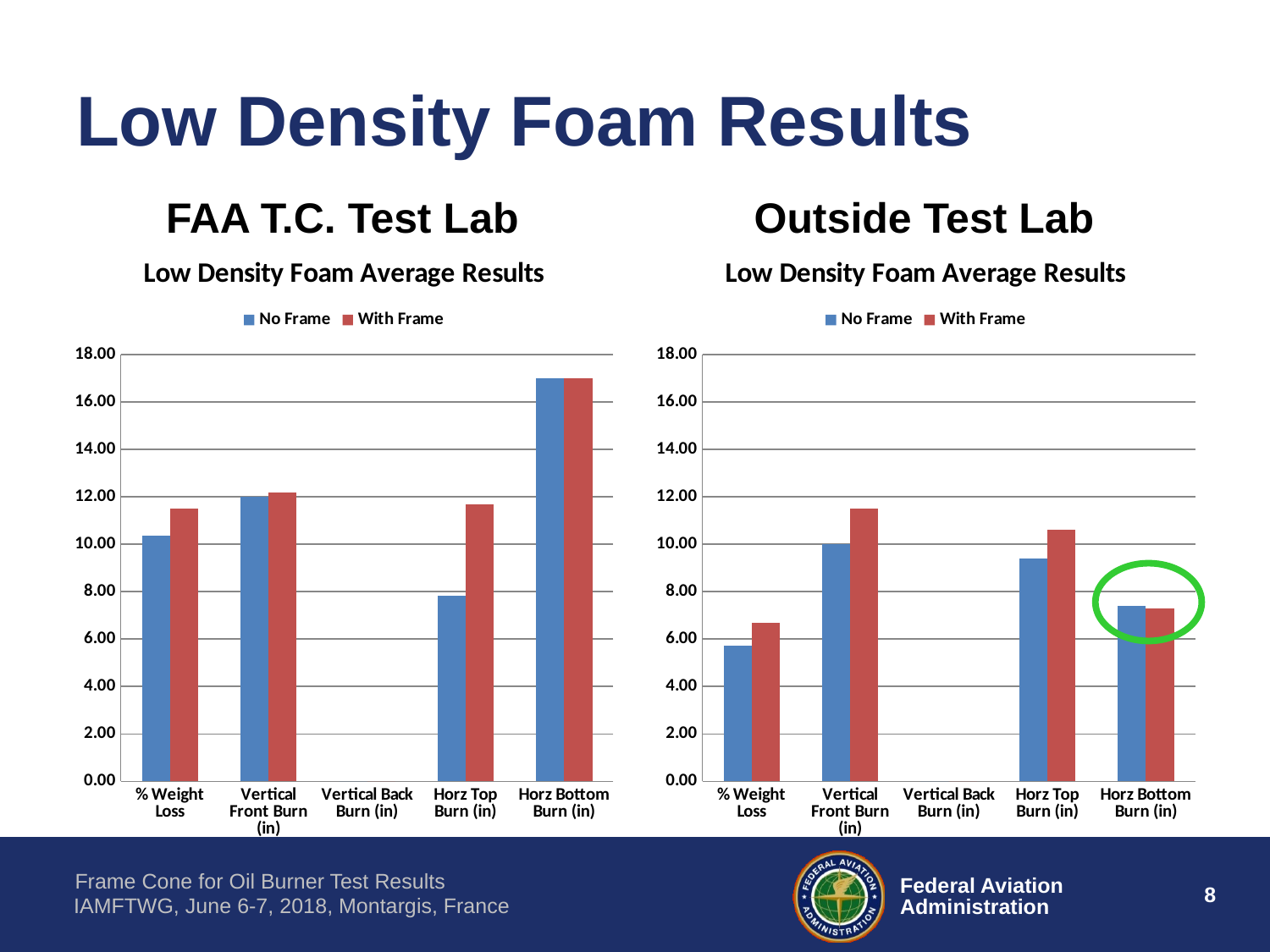
In the FAA T.C. Test Lab chart, which category has the highest No Frame value? Horz Bottom Burn (in) In the Outside Test Lab chart, which category has the highest With Frame value? Vertical Front Burn (in) In the Outside Test Lab chart, which category is circled in green? Horz Bottom Burn (in) In the Outside Test Lab chart, which category has the lowest values, showing no visible bars? Vertical Back Burn (in) In the Outside Test Lab chart, is the With Frame value for Vertical Front Burn (in) greater or less than 10.00? greater What kind of chart is the FAA T.C. Test Lab chart? bar chart In the FAA T.C. Test Lab chart, is the With Frame value for Horz Top Burn (in) greater or less than 10.00? greater In the FAA T.C. Test Lab chart, for Horz Top Burn (in), which is larger: No Frame or With Frame? With Frame How many categories are shown on the x axis of the FAA T.C. Test Lab chart? 5 In the FAA T.C. Test Lab chart, what colour represents the With Frame series? red In the Outside Test Lab chart, for Horz Top Burn (in), which is larger: No Frame or With Frame? With Frame How many series does the legend of the Outside Test Lab chart list? 2